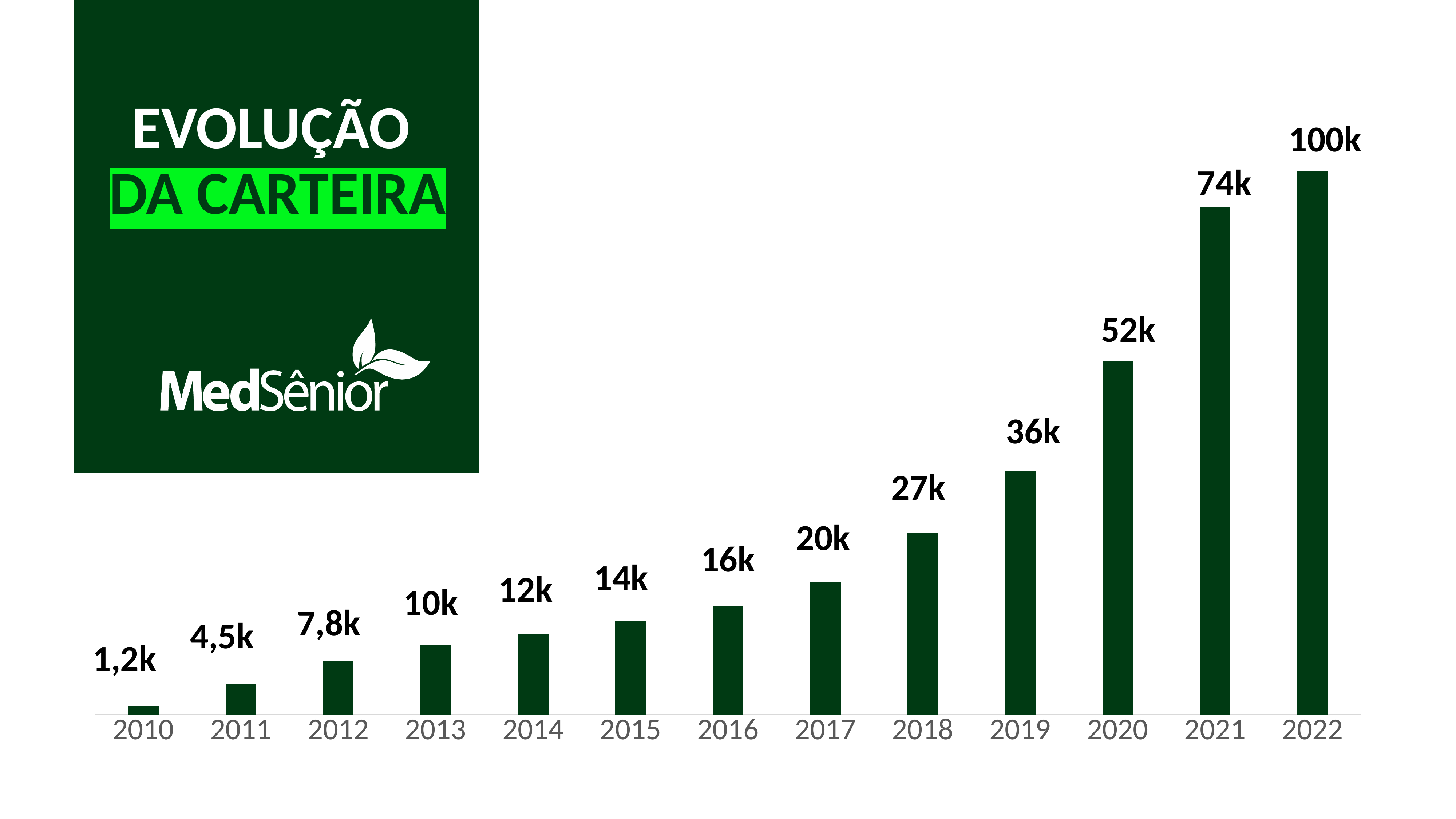
What kind of chart is shown on the slide? Bar chart What is the value for 2015? 14k Do the values rise or fall from 2010 to 2022? Rise What is the difference between the values for 2019 and 2018? 9k How many years are shown on the x axis? 13 What is the difference between the values for 2022 and 2021? 26k Which year has the highest value? 2022 Which is larger, the value for 2017 or the value for 2016? 2017 What is the value for 2020? 52k What is the value for 2010? 1,2k What is the title shown on the slide? EVOLUÇÃO DA CARTEIRA Which year has the lowest value? 2010